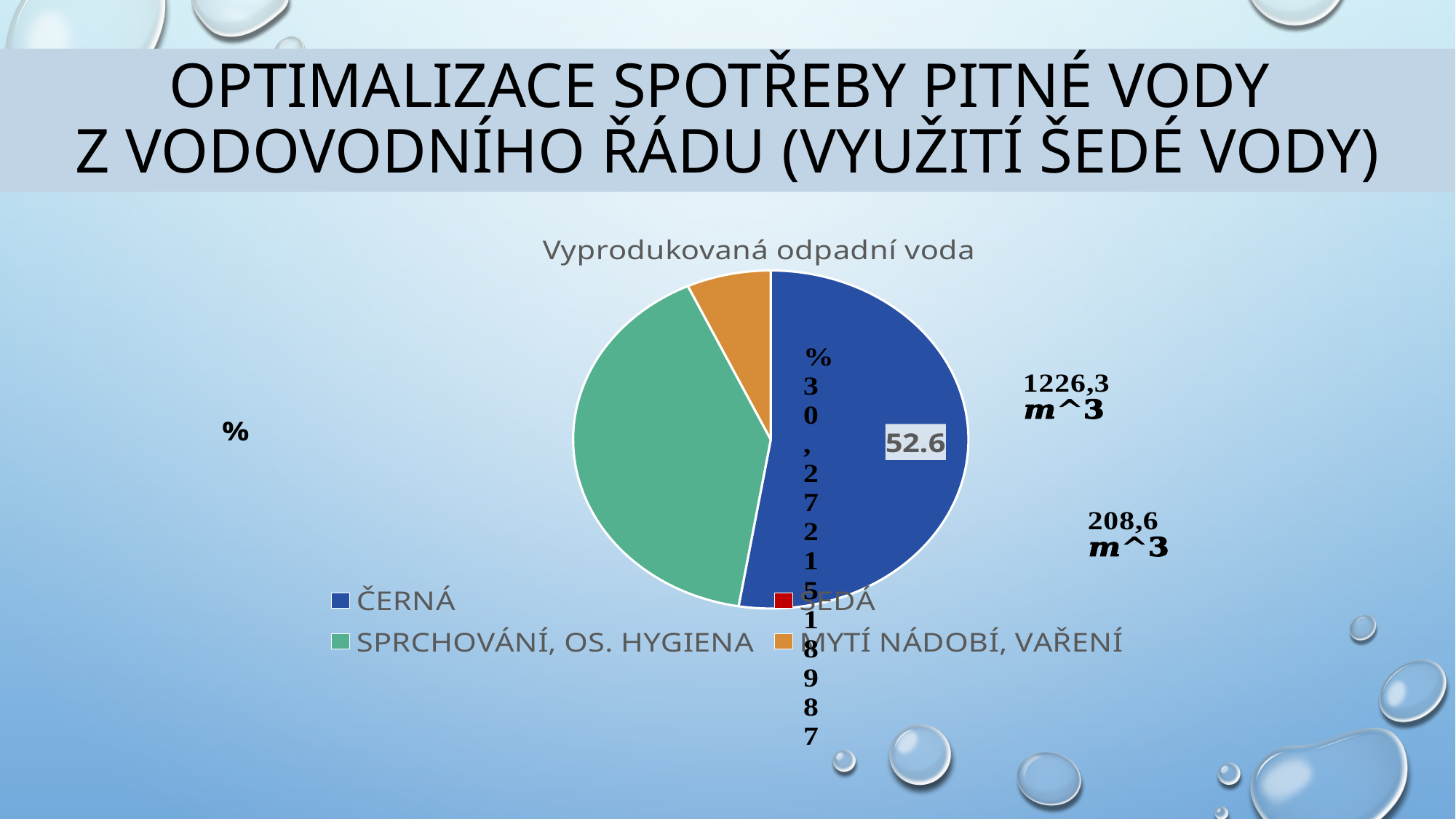
What share of the pie does the ČERNÁ slice represent, according to its data label? 52.6 How many entries does the chart legend list? 4 Is the ČERNÁ slice more or less than half of the pie? more What colour is the ČERNÁ slice in the pie chart? blue What value is labelled on the ČERNÁ slice of the pie? 52.6 Which slice is larger, SPRCHOVÁNÍ, OS. HYGIENA or MYTÍ NÁDOBÍ, VAŘENÍ? SPRCHOVÁNÍ, OS. HYGIENA What is the title of the chart? Vyprodukovaná odpadní voda Which category has the largest slice of the pie? ČERNÁ Which slice is larger, ČERNÁ or SPRCHOVÁNÍ, OS. HYGIENA? ČERNÁ What kind of chart is shown on the slide? pie chart